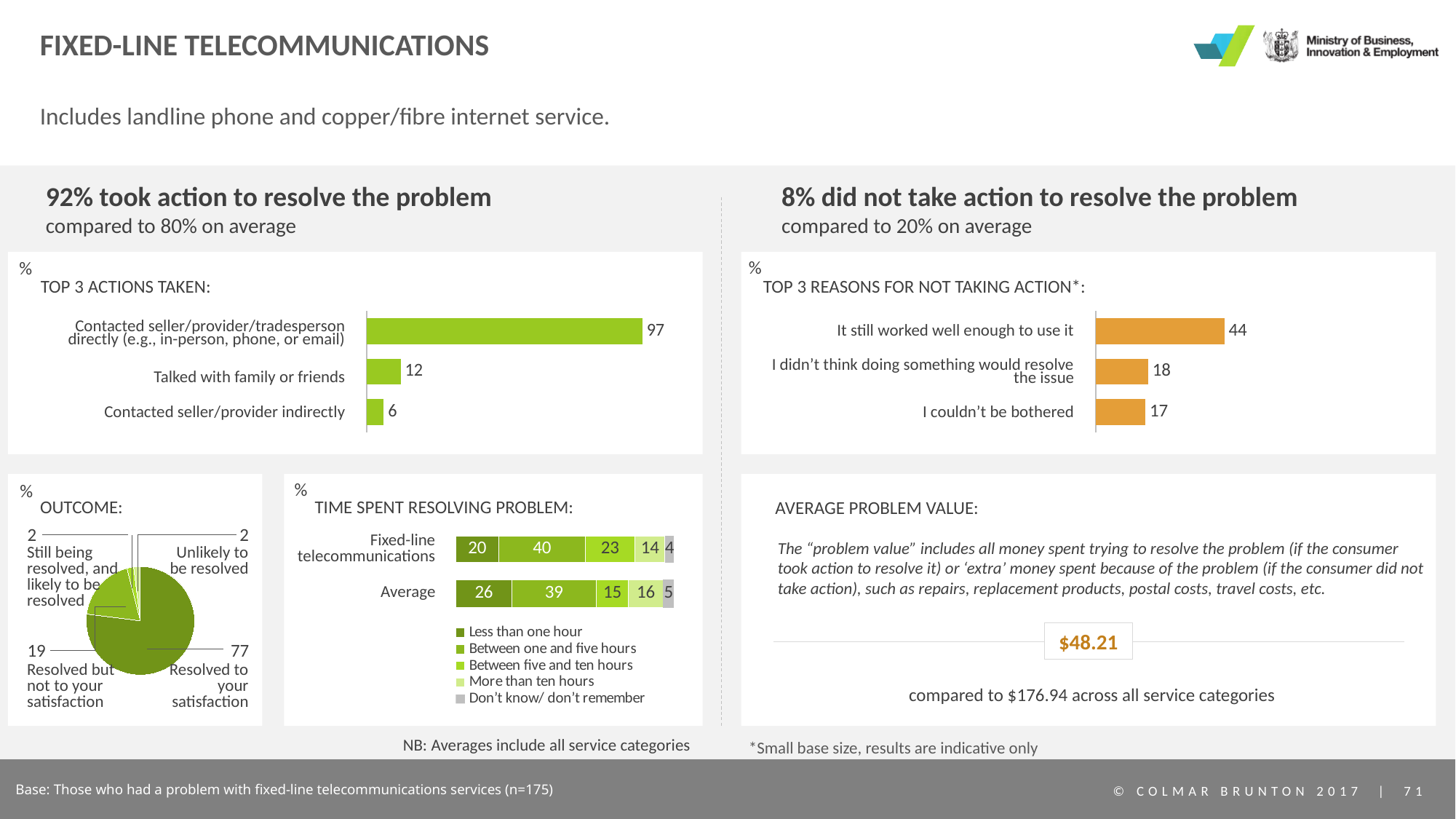
In the 'Top 3 reasons for not taking action' chart, what is the value for 'It still worked well enough to use it'? 44 In the 'Top 3 actions taken' chart, which action has the lowest value? Contacted seller/provider indirectly In the 'Time spent resolving problem' chart, how many series does the legend list? 5 In the 'Time spent resolving problem' chart, what is the value for 'Between one and five hours' for Fixed-line telecommunications? 40 In the 'Top 3 reasons for not taking action' chart, how many reasons are shown? 3 In the 'Outcome' pie chart, what percentage were resolved to your satisfaction? 77 In the 'Top 3 reasons for not taking action' chart, which reason has the highest value? It still worked well enough to use it In the 'Top 3 actions taken' chart, what is the difference between 'Talked with family or friends' and 'Contacted seller/provider indirectly'? 6 In the 'Time spent resolving problem' chart, which is larger for 'Less than one hour': Fixed-line telecommunications or Average? Average In the 'Top 3 actions taken' chart, what percentage contacted the seller/provider/tradesperson directly? 97 In the 'Outcome' pie chart, what is the value for 'Resolved but not to your satisfaction'? 19 What kind of chart is the 'Top 3 actions taken' chart? Bar chart